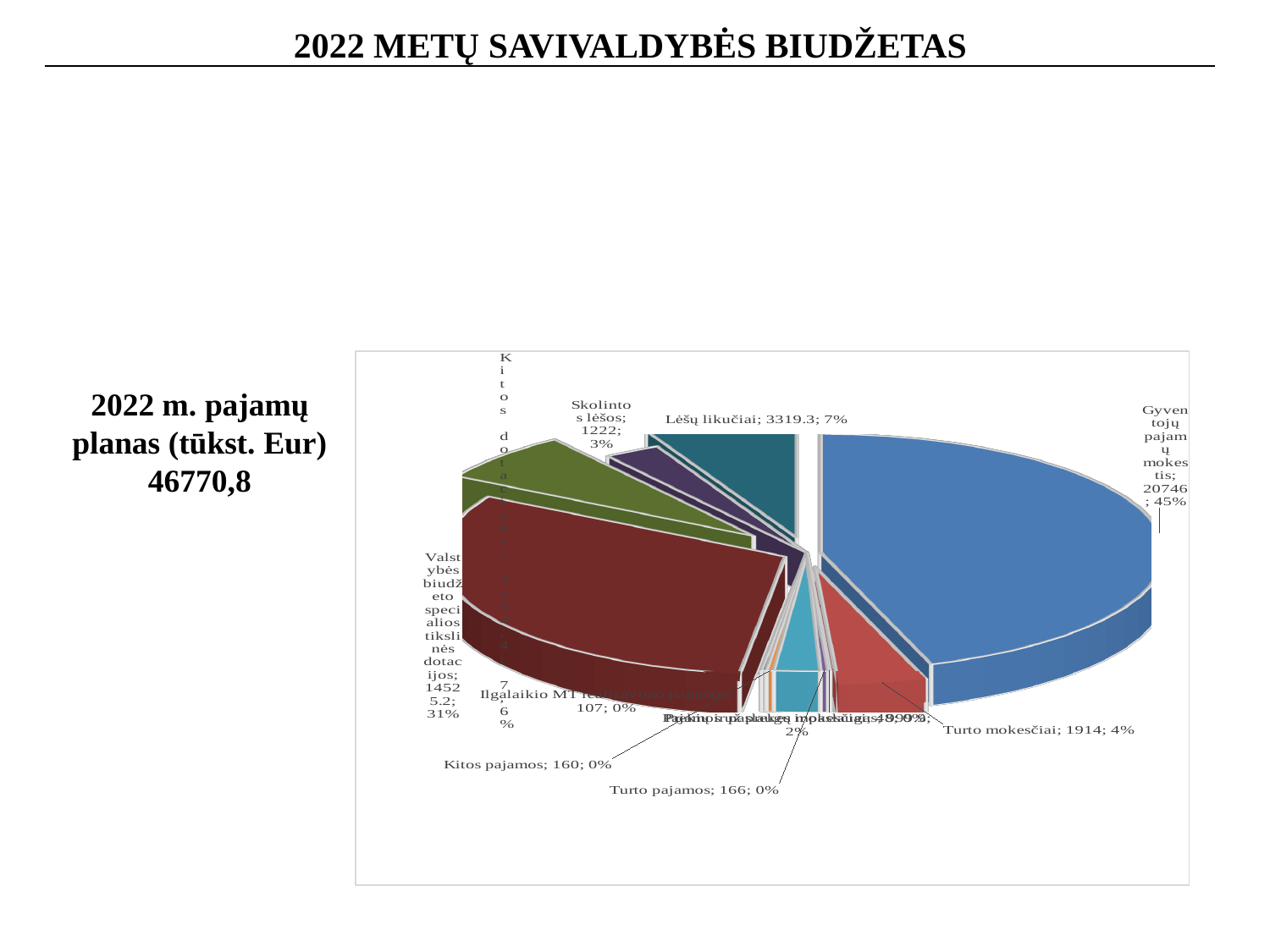
What value is shown for Valstybės biudžeto specialios tikslinės dotacijos? 14525.2 What share of the pie does Valstybės biudžeto specialios tikslinės dotacijos represent? 31% What value is shown for Skolintos lėšos? 1222 What share of the pie does Gyventojų pajamų mokestis represent? 45% Which is larger, Turto pajamos or Kitos pajamos? Turto pajamos What value is shown for Gyventojų pajamų mokestis in the pie chart? 20746 What value is shown for Lėšų likučiai? 3319.3 What value is shown for Turto mokesčiai? 1914 What is the difference between the values for Gyventojų pajamų mokestis and Valstybės biudžeto specialios tikslinės dotacijos? 6220.8 What is the difference between the values for Turto mokesčiai and Skolintos lėšos? 692 What kind of chart is shown on the slide? Pie chart Which category has the largest slice of the pie? Gyventojų pajamų mokestis